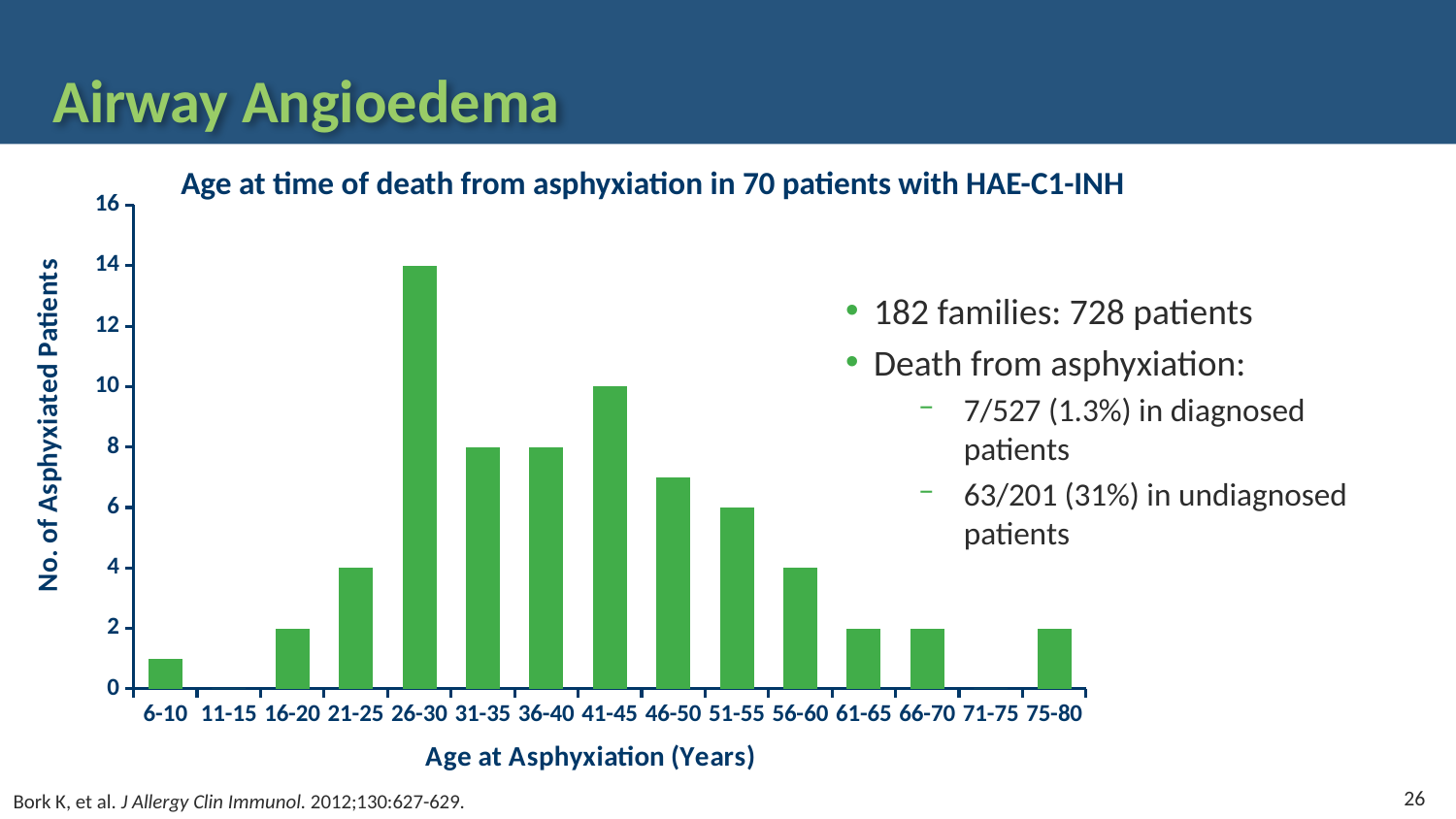
How many asphyxiated patients are shown for the 26-30 age group? 14 Which age group has more asphyxiated patients, 31-35 or 51-55? 31-35 Which age group has the highest number of asphyxiated patients? 26-30 How many age group categories are shown on the x axis? 15 How many asphyxiated patients are shown for the 51-55 age group? 6 What kind of chart is shown on the slide? bar chart How many asphyxiated patients are shown for the 21-25 age group? 4 What is the difference in number of asphyxiated patients between the 26-30 and 41-45 age groups? 4 Is the value for the 6-10 age group greater or less than 2? less Is the value for the 46-50 age group greater or less than 6? greater How many asphyxiated patients are shown for the 41-45 age group? 10 What is the title of the chart? Age at time of death from asphyxiation in 70 patients with HAE-C1-INH